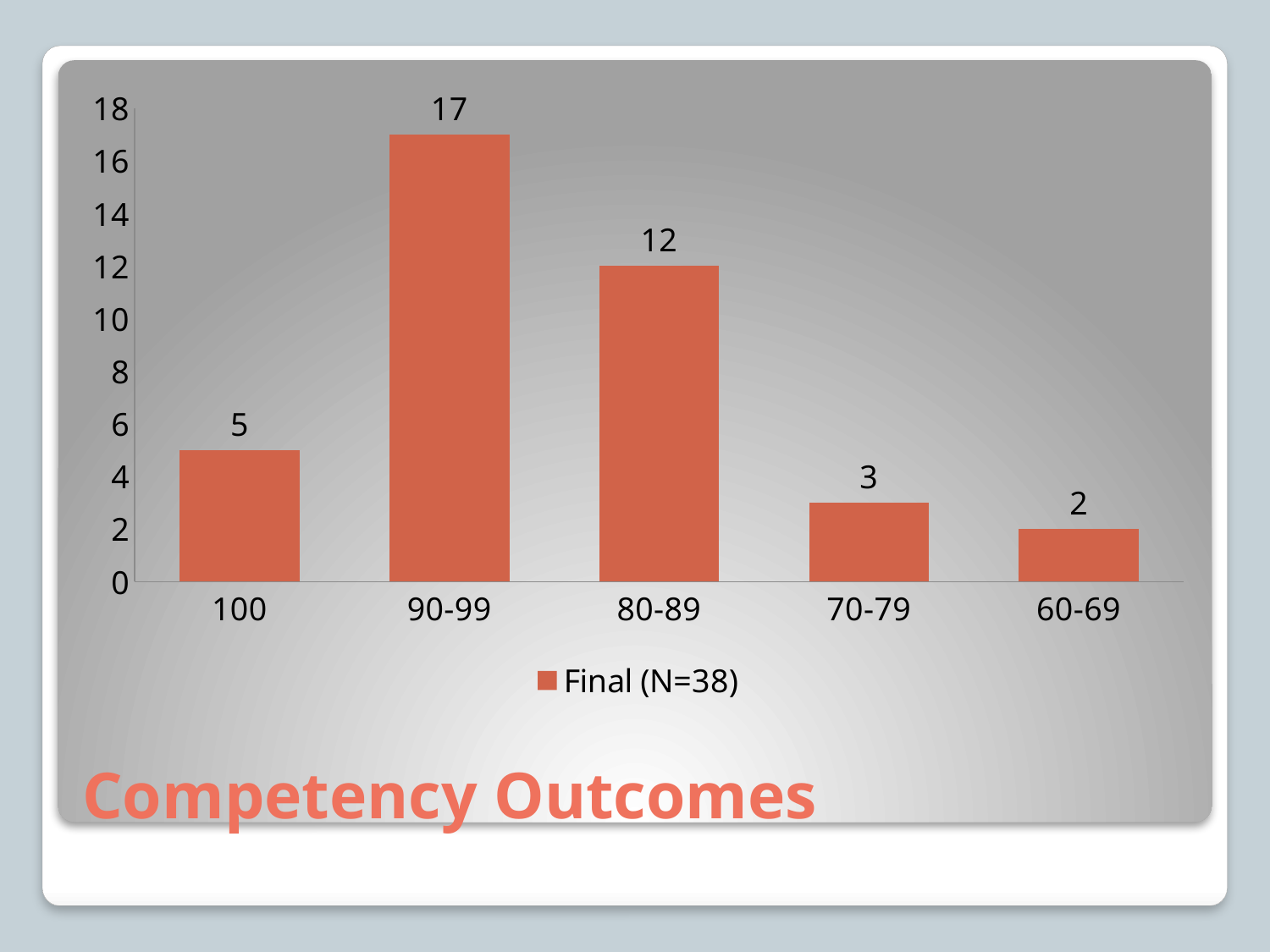
What is the value for the 90-99 category? 17 What is the difference between the values for 90-99 and 80-89? 5 What is the value for the 100 category? 5 Which category has the lowest value? 60-69 How many series does the legend list? 1 What is the value for the 60-69 category? 2 How many categories are shown on the x axis? 5 Which category has the highest value? 90-99 Which is larger, the value for 100 or the value for 70-79? 100 Is the value for 80-89 greater or less than 10? greater What is the legend entry for the series shown? Final (N=38) What kind of chart is shown on the slide? bar chart